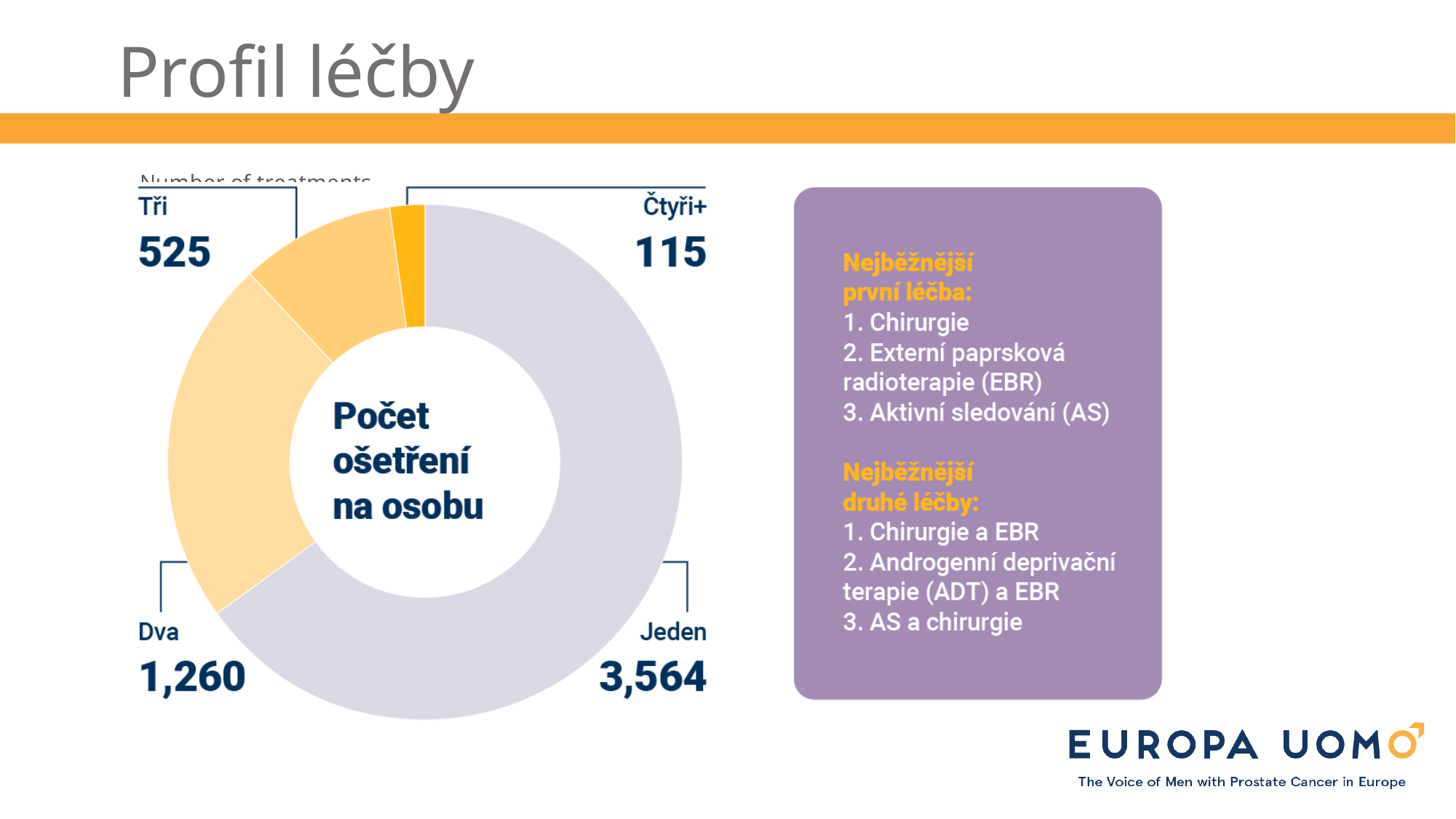
What text is written in the centre of the donut chart? Počet ošetření na osobu Which segment of the donut chart has the highest value? Jeden Which is larger in the donut chart, the value for 'Dva' or the value for 'Tři'? Dva How many segments does the donut chart have? 4 Which segment of the donut chart has the lowest value? Čtyři+ What is the difference between the 'Jeden' and 'Dva' values in the donut chart? 2,304 What is the value for the 'Tři' segment of the donut chart? 525 What is the value for the 'Čtyři+' segment of the donut chart? 115 What is the difference between the 'Tři' and 'Čtyři+' values in the donut chart? 410 What is the value for the 'Dva' segment of the donut chart? 1,260 What kind of chart is shown on the slide? Donut (pie) chart What is the value for the 'Jeden' segment of the donut chart? 3,564